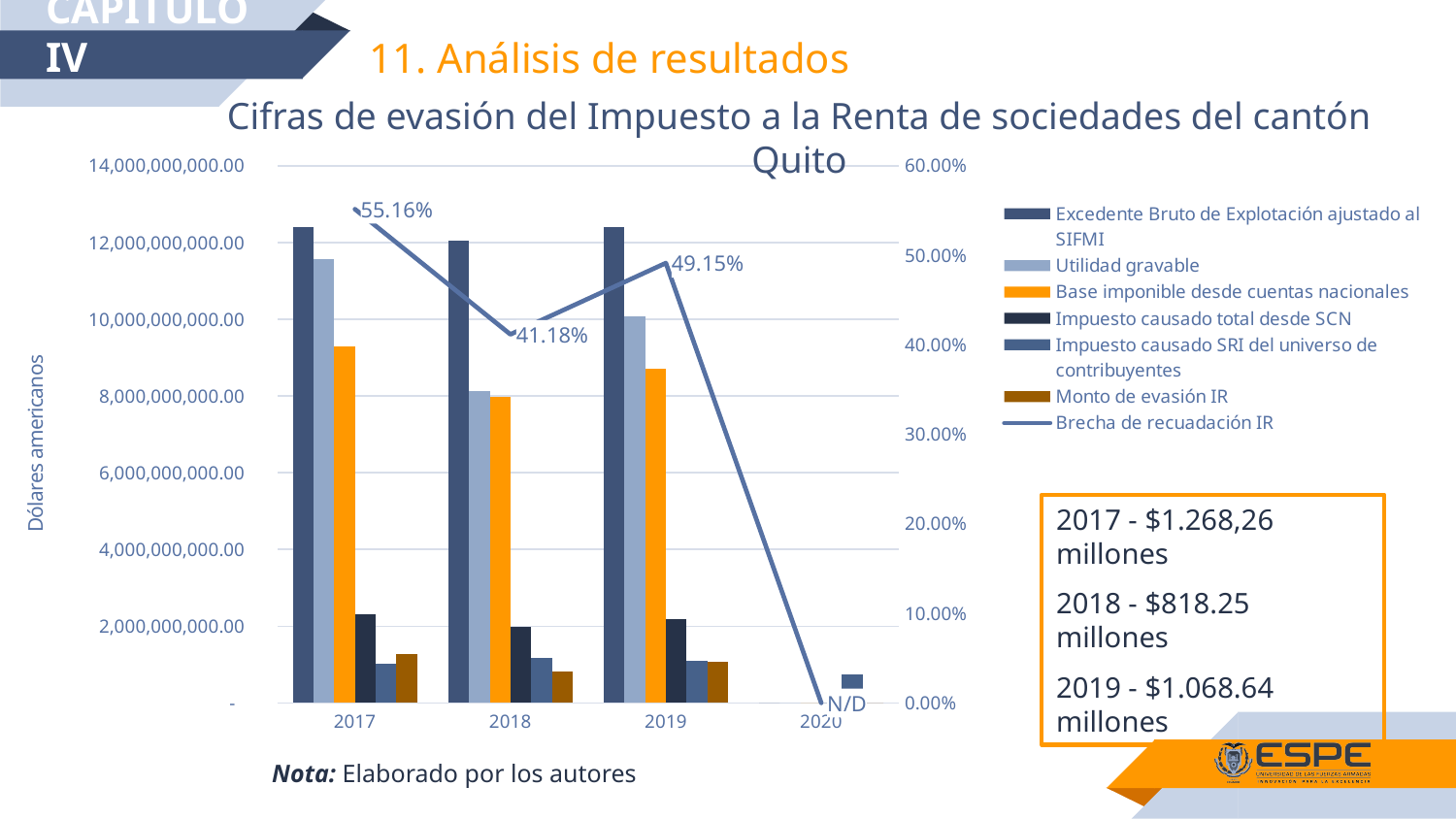
What is the value of Brecha de recuadación IR for 2018? 41.18% In which year is Brecha de recuadación IR highest? 2017 Is the value for Base imponible desde cuentas nacionales in 2017 greater or less than 10,000,000,000.00? less What is the value of Brecha de recuadación IR for 2019? 49.15% Is the value for Excedente Bruto de Explotación ajustado al SIFMI in 2017 greater or less than 12,000,000,000.00? greater Among the years with a printed percentage, in which year is Brecha de recuadación IR lowest? 2018 What is the value of Brecha de recuadación IR for 2017? 55.16% How many series does the legend list? 7 Which year has a larger Brecha de recuadación IR, 2017 or 2019? 2017 What is the difference in Brecha de recuadación IR between 2017 and 2018? 13.98 percentage points Does Brecha de recuadación IR rise or fall from 2017 to 2018? fall What label is shown for Brecha de recuadación IR in 2020? N/D